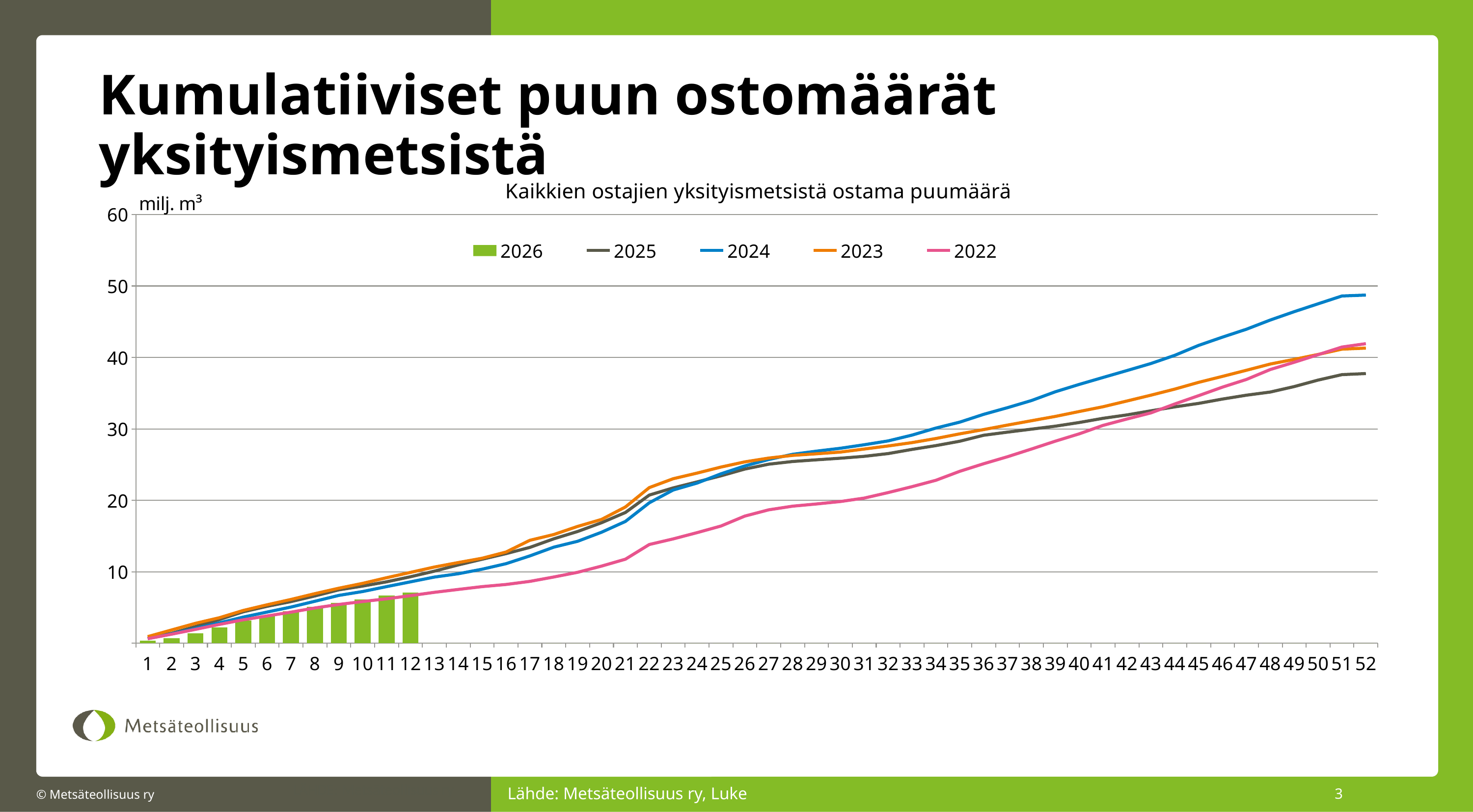
Is the value for 2026 at week 12 greater or less than 10? less At week 40, which is larger: the value for 2023 or the value for 2022? 2023 Which series has the lowest value at week 52? 2025 How many points are shown along the x axis? 52 Do the line series rise or fall along the x axis? rise What kind of chart is this? A combined bar and line chart Which series has the lowest value at week 30? 2022 How many series does the legend list? 5 Which series has the highest value at week 52? 2024 Is the value for 2024 at week 52 greater or less than 40? greater How many bars are plotted for the 2026 series? 12 Is the value for 2022 at week 36 greater or less than 30? less